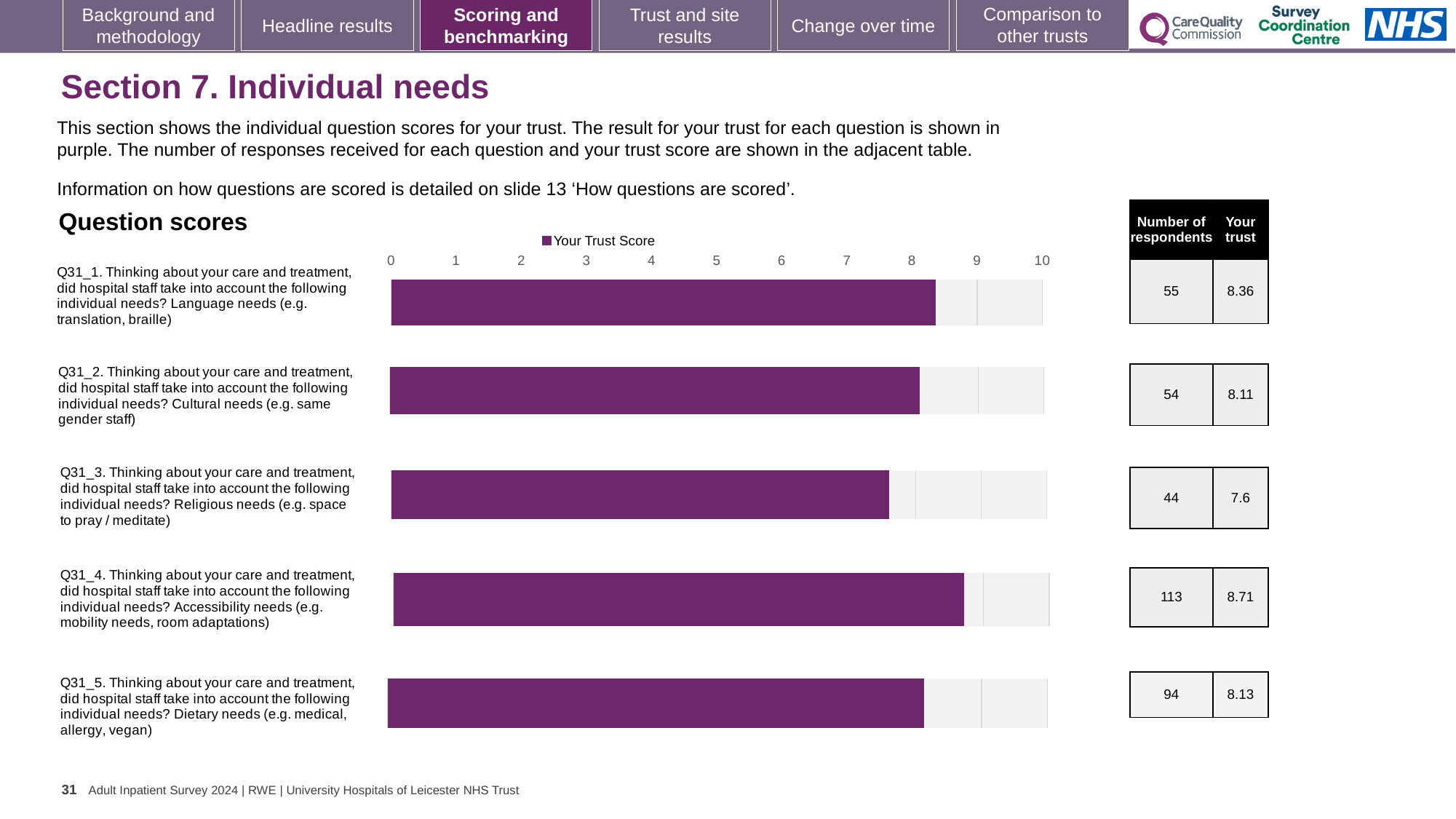
What is the name of the series shown in the chart legend? Your Trust Score What is the trust score for Q31_3 (Religious needs)? 7.6 What is the trust score for Q31_1 (Language needs)? 8.36 How many questions are plotted in the chart? 5 What is the difference between the trust scores for Q31_4 and Q31_3? 1.11 Is the trust score for Q31_3 (Religious needs) greater or less than 8? less What type of chart is shown on the slide? Bar chart Which question has the highest trust score? Q31_4 (Accessibility needs) How many series does the chart legend list? 1 Which question has the lowest trust score? Q31_3 (Religious needs) What is the trust score for Q31_4 (Accessibility needs)? 8.71 Which has a higher trust score, Q31_1 (Language needs) or Q31_5 (Dietary needs)? Q31_1 (Language needs)